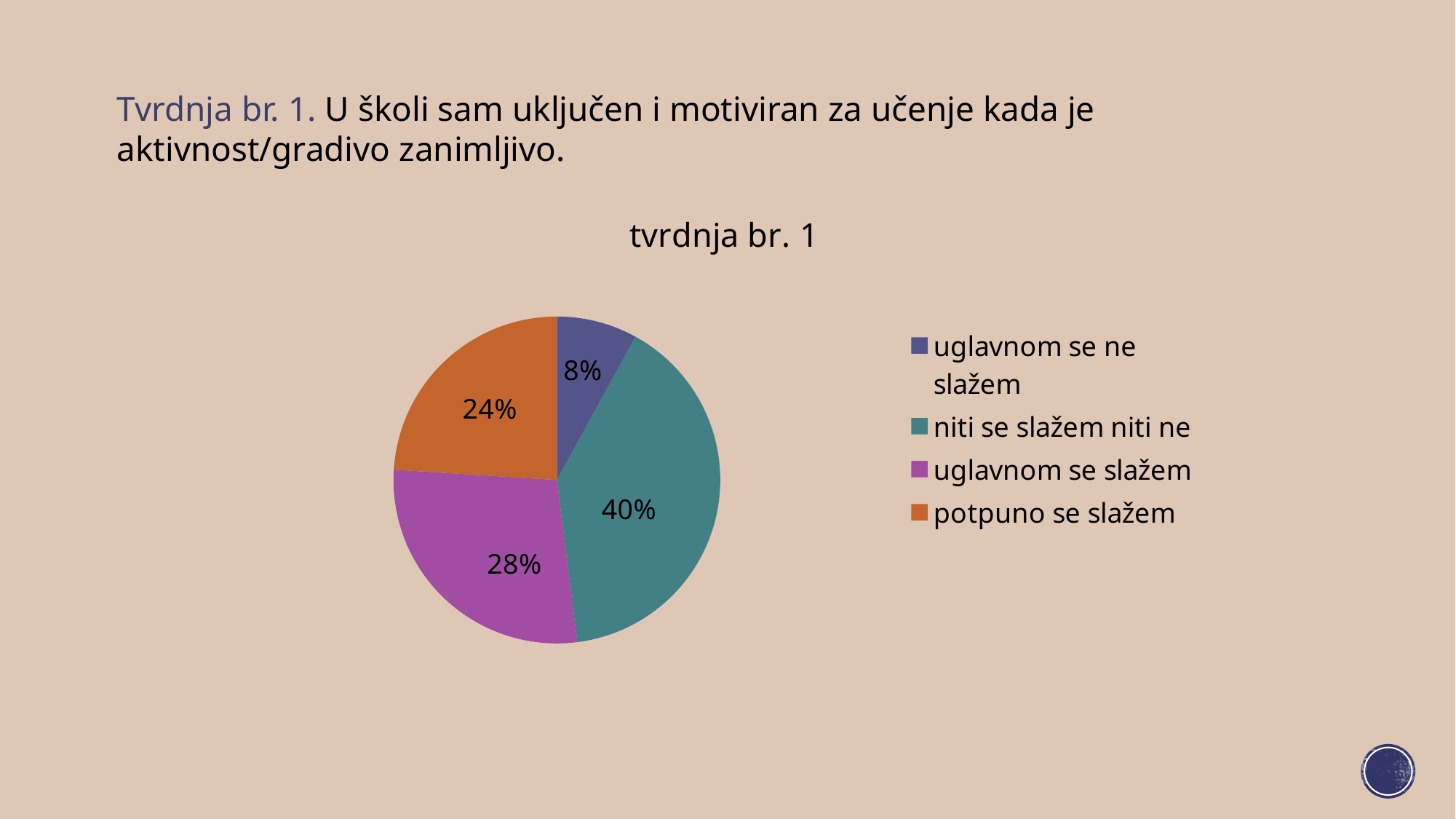
What share of the pie is 'niti se slažem niti ne'? 40% What colour is the slice for 'potpuno se slažem'? orange What kind of chart is shown on the slide? pie chart What share of the pie is 'uglavnom se slažem'? 28% Which category has the smallest slice of the pie? uglavnom se ne slažem What share of the pie is 'potpuno se slažem'? 24% Which category has the largest slice of the pie? niti se slažem niti ne What is the difference between the shares for 'niti se slažem niti ne' and 'potpuno se slažem'? 16% How many categories does the legend list? 4 Which is larger, the share for 'uglavnom se slažem' or the share for 'potpuno se slažem'? uglavnom se slažem What is the title of the chart? tvrdnja br. 1